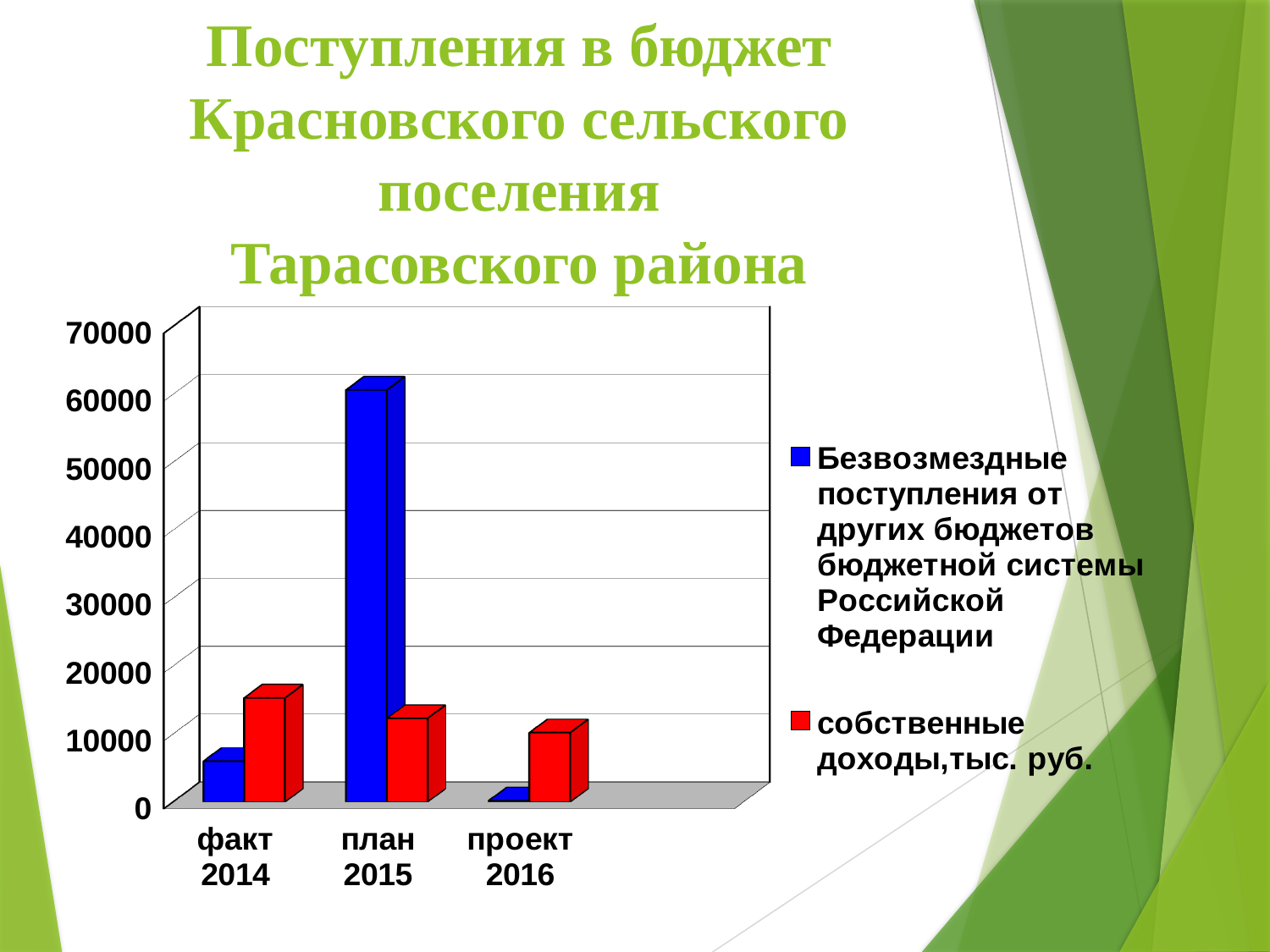
What kind of chart is shown on the slide? bar chart For факт 2014, which is larger: Безвозмездные поступления or собственные доходы? собственные доходы Which category has the highest value for the red series (собственные доходы,тыс. руб.)? факт 2014 Is the value of Безвозмездные поступления for факт 2014 greater or less than 10000? less Is the value of собственные доходы for факт 2014 greater or less than 20000? less For план 2015, which is larger: Безвозмездные поступления or собственные доходы? Безвозмездные поступления How many series does the chart's legend list? 2 Which category has the lowest value for the blue series (Безвозмездные поступления)? проект 2016 Is the value of Безвозмездные поступления for план 2015 greater or less than 50000? greater How many categories are shown on the x axis of the chart? 3 Do the values of собственные доходы rise or fall from факт 2014 to проект 2016? fall Which category has the highest value for the blue series (Безвозмездные поступления от других бюджетов бюджетной системы Российской Федерации)? план 2015